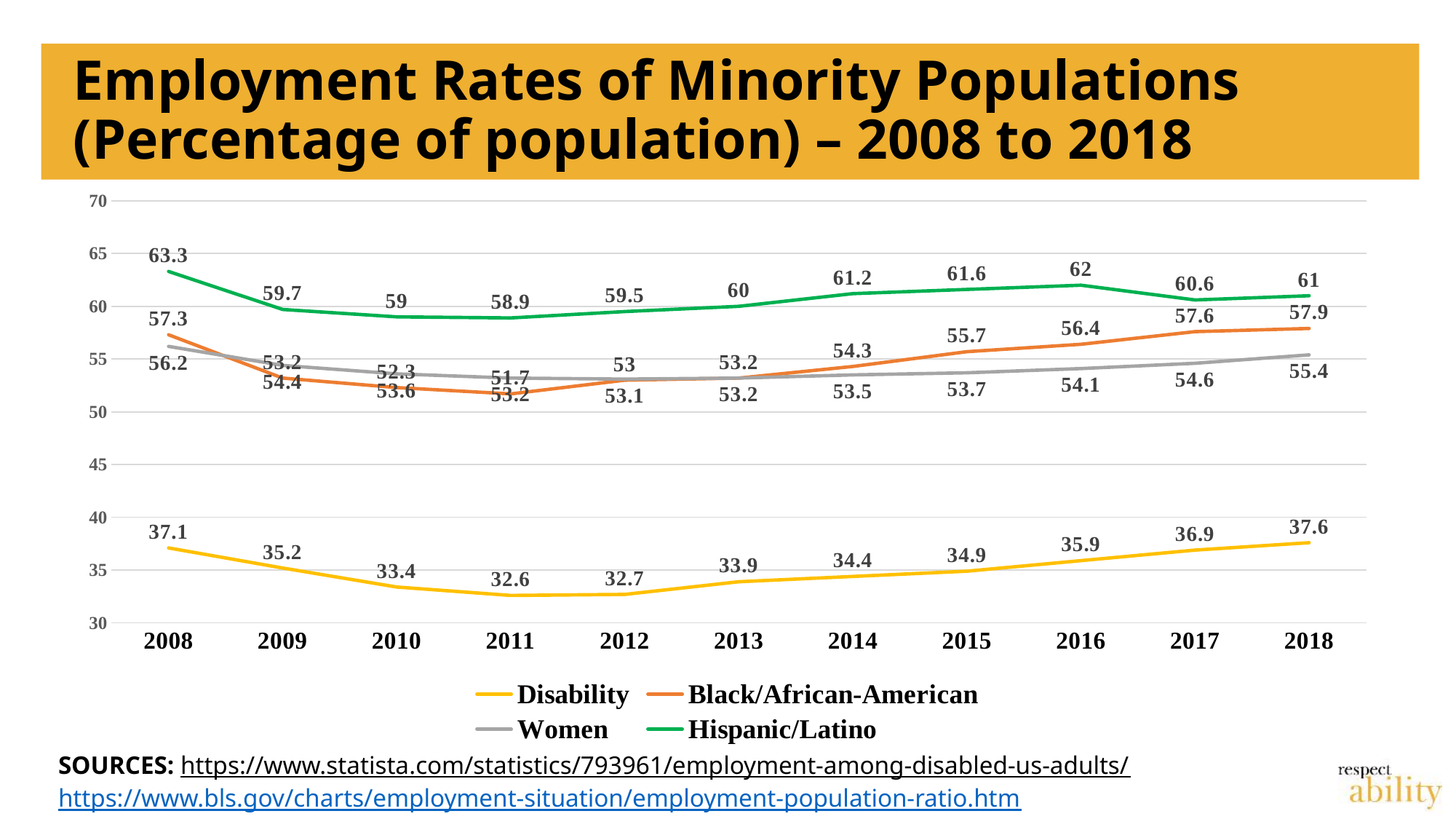
How many series does the legend list? 4 What is the employment rate for Hispanic/Latino in 2008? 63.3 What is the employment rate for Black/African-American in 2016? 56.4 Does the Disability employment rate rise or fall from 2011 to 2018? rise In which year is the Disability employment rate highest? 2018 How many years are plotted along the x axis? 11 In 2018, which is higher: the Black/African-American rate or the Women rate? Black/African-American What kind of chart is shown on the slide? Line chart What is the employment rate for the Disability series in 2011? 32.6 What is the difference between the Disability employment rate in 2018 and in 2008? 0.5 Is the Disability employment rate in 2008 greater or less than 40? less In which year is the Hispanic/Latino employment rate lowest? 2011